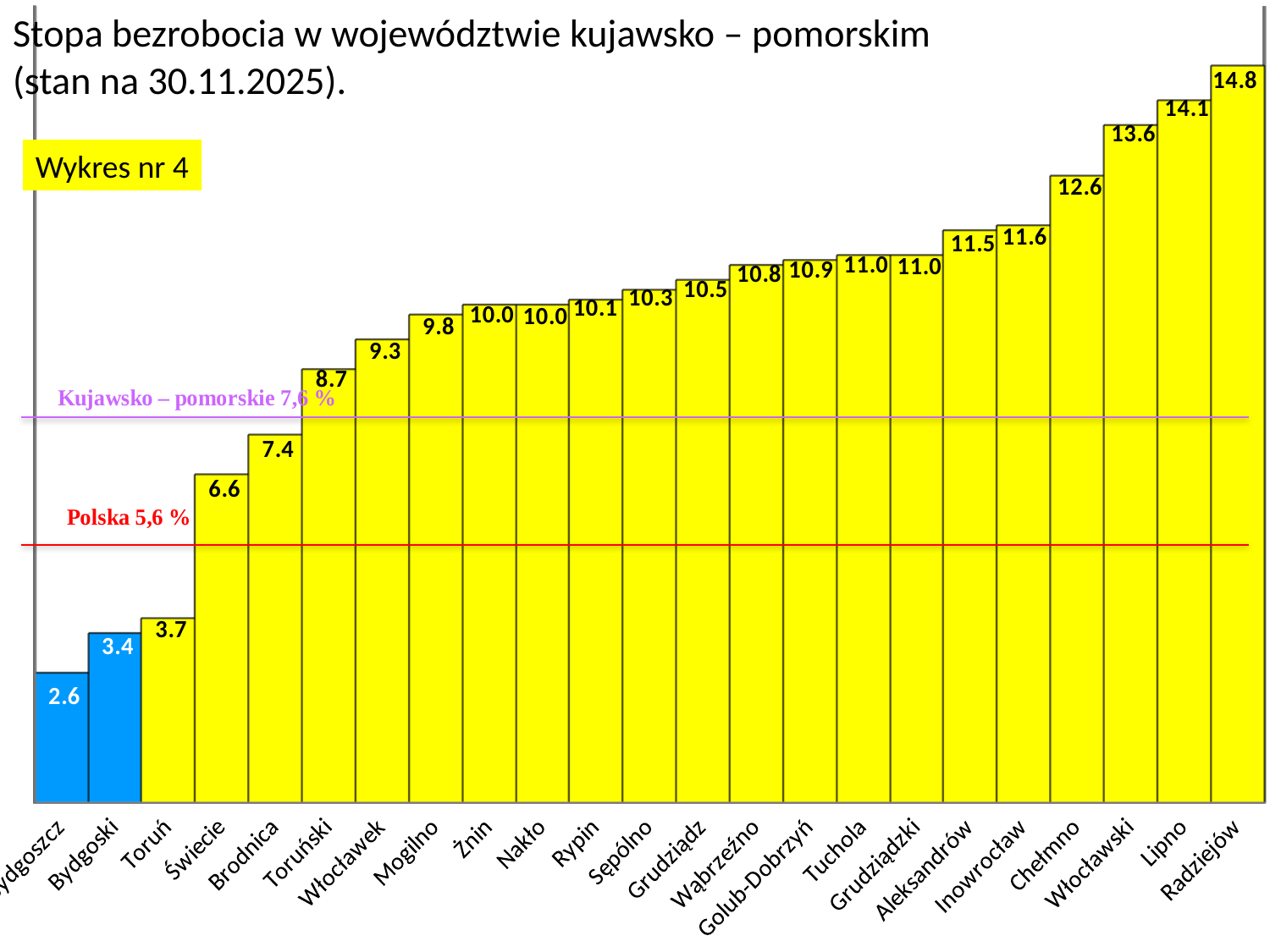
What is the lowest value shown on the chart? 2.6 Which has a higher value, Brodnica or Mogilno? Mogilno What value is shown for Świecie? 6.6 What value is shown for Chełmno? 12.6 What is the difference between the values for Lipno and Włocławski? 0.5 What value does the red reference line labelled Polska indicate? 5,6 % How many bars are shown on the chart? 23 What is the unemployment rate shown for Radziejów? 14.8 What kind of chart is shown on the slide? bar chart What value is shown for Toruński? 8.7 Which category has the highest value? Radziejów What is the difference between the values for Radziejów and Toruń? 11.1